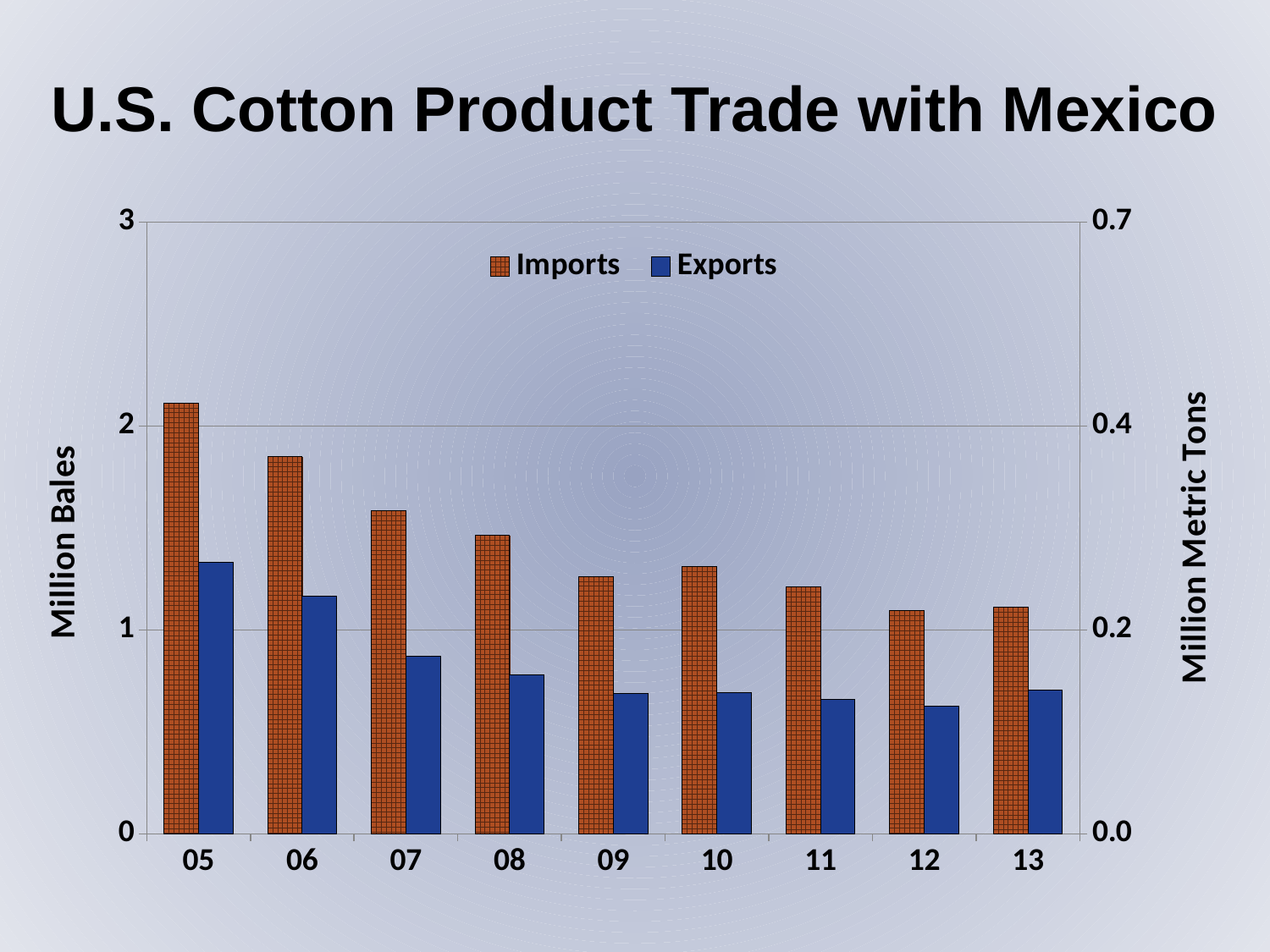
Is the Imports value for 06 greater or less than 2? less How many series does the legend list? 2 In which year are Exports highest? 05 Is the Imports value for 05 greater or less than 2? greater Is the Exports value for 05 greater or less than 1? greater How many years are shown on the x axis? 9 In which year are Imports highest? 05 Which is larger, Imports in 05 or Imports in 13? Imports in 05 What is the title of the chart? U.S. Cotton Product Trade with Mexico Do Imports generally rise or fall from 05 to 13? Fall What kind of chart is shown on the slide? Bar chart